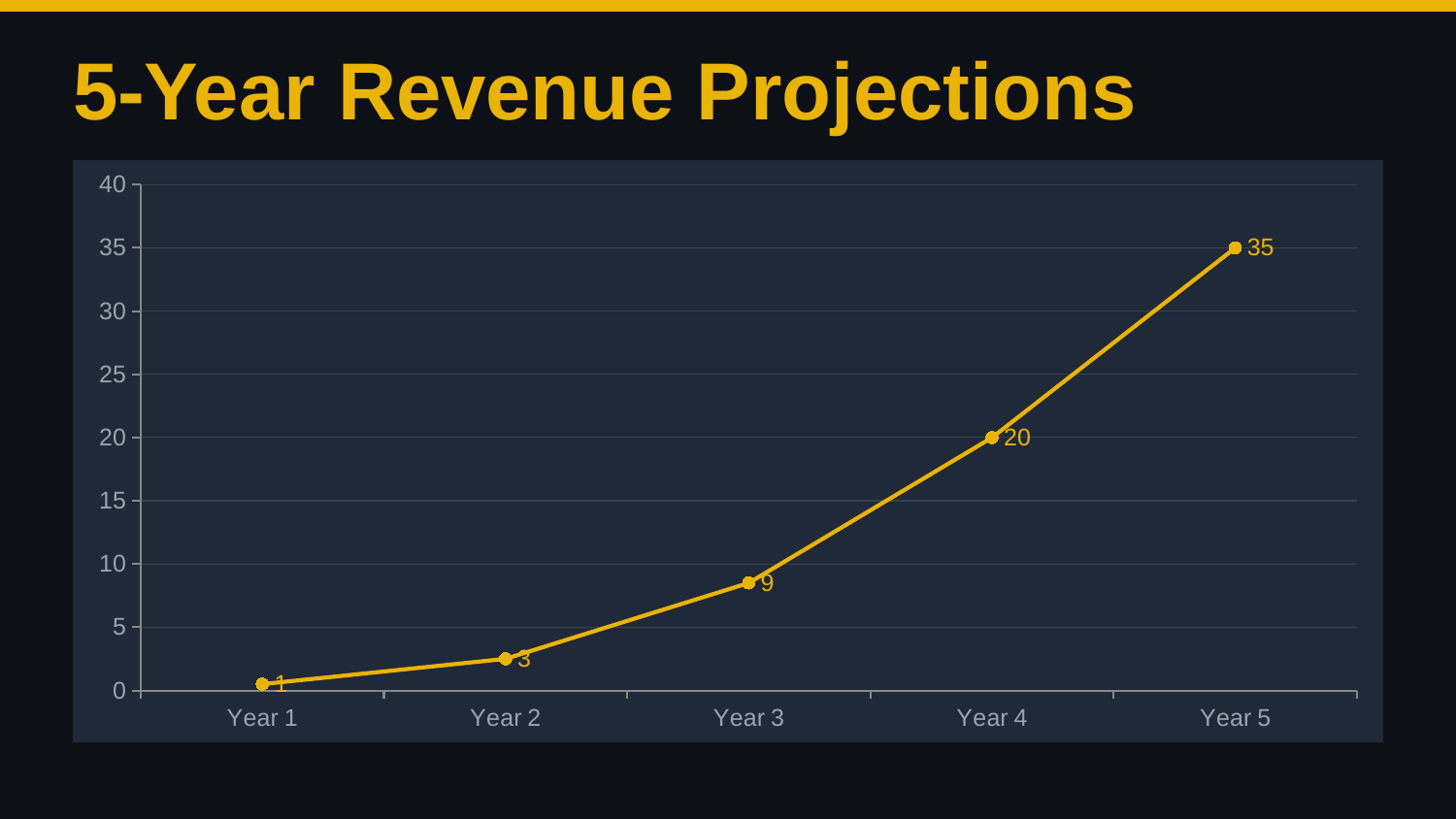
Which year has the highest value? Year 5 Which is larger, the value for Year 3 or the value for Year 4? Year 4 How many years are plotted on the x axis? 5 Which year has the lowest value? Year 1 What is the value for Year 5? 35 Is the value for Year 4 greater or less than 15? greater What is the value for Year 2? 3 What is the difference between the values for Year 5 and Year 4? 15 What is the value for Year 4? 20 What is the value for Year 3? 9 What type of chart is shown on the slide? line chart What is the title of the chart? 5-Year Revenue Projections